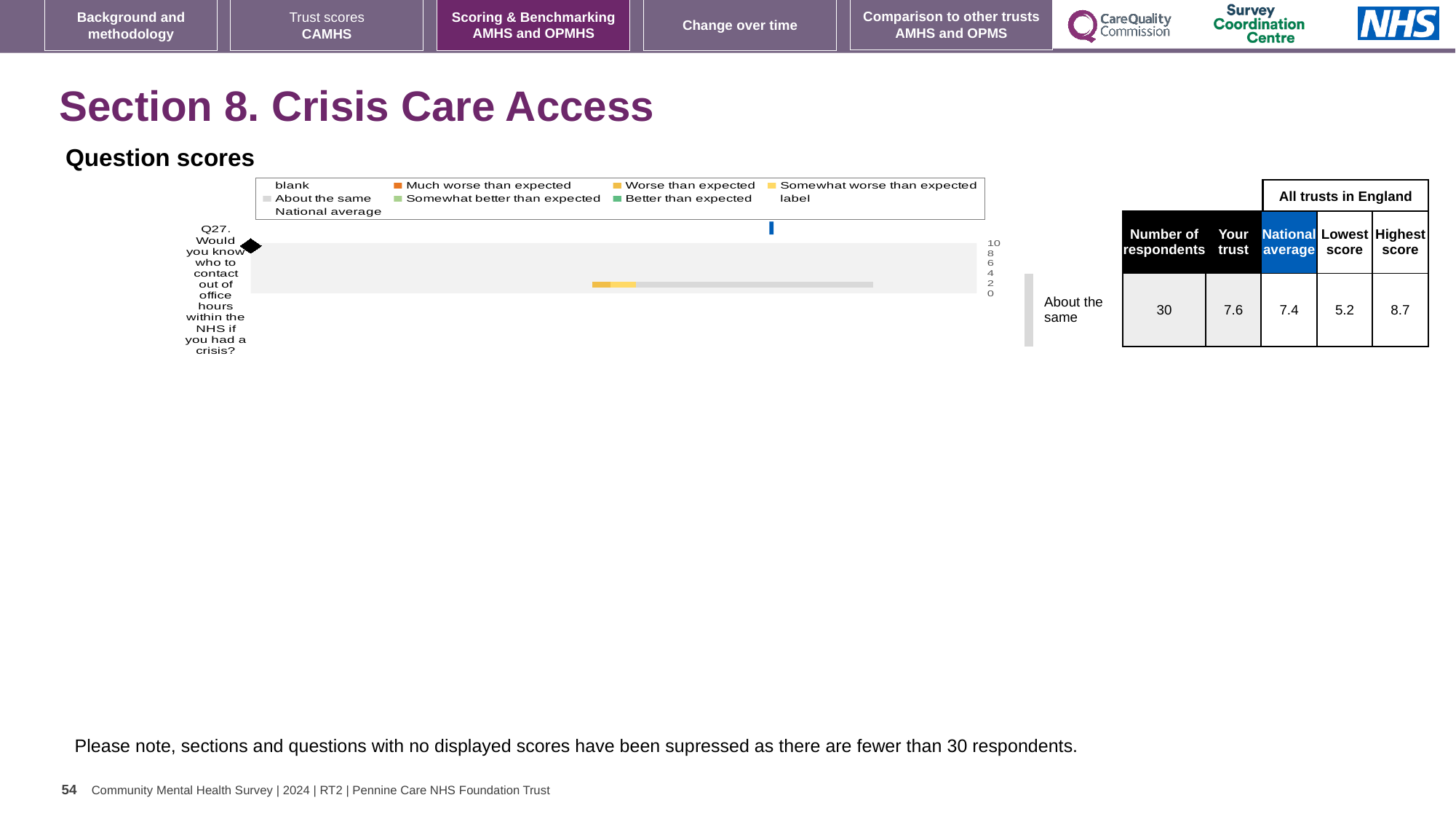
What kind of chart is used to show the question scores for Section 8? bar chart What is the highest score among all trusts in England for Q27? 8.7 How many questions are plotted in the Section 8 question scores chart? 1 What benchmark category is shown for Q27 in the Section 8 chart? About the same Which question is plotted in the Section 8 question scores chart? Q27. Would you know who to contact out of office hours within the NHS if you had a crisis? What is the lowest score among all trusts in England for Q27? 5.2 For Q27, what is the difference between the highest score and the lowest score among all trusts in England? 3.5 What is the national average score for Q27 in the Section 8 question scores? 7.4 How many respondents answered Q27 in the Section 8 question scores? 30 For Q27, which is larger: the 'Your trust' score or the national average? Your trust For Q27, how much higher is the 'Your trust' score than the national average? 0.2 What is the 'Your trust' score for Q27 in the Section 8 question scores? 7.6